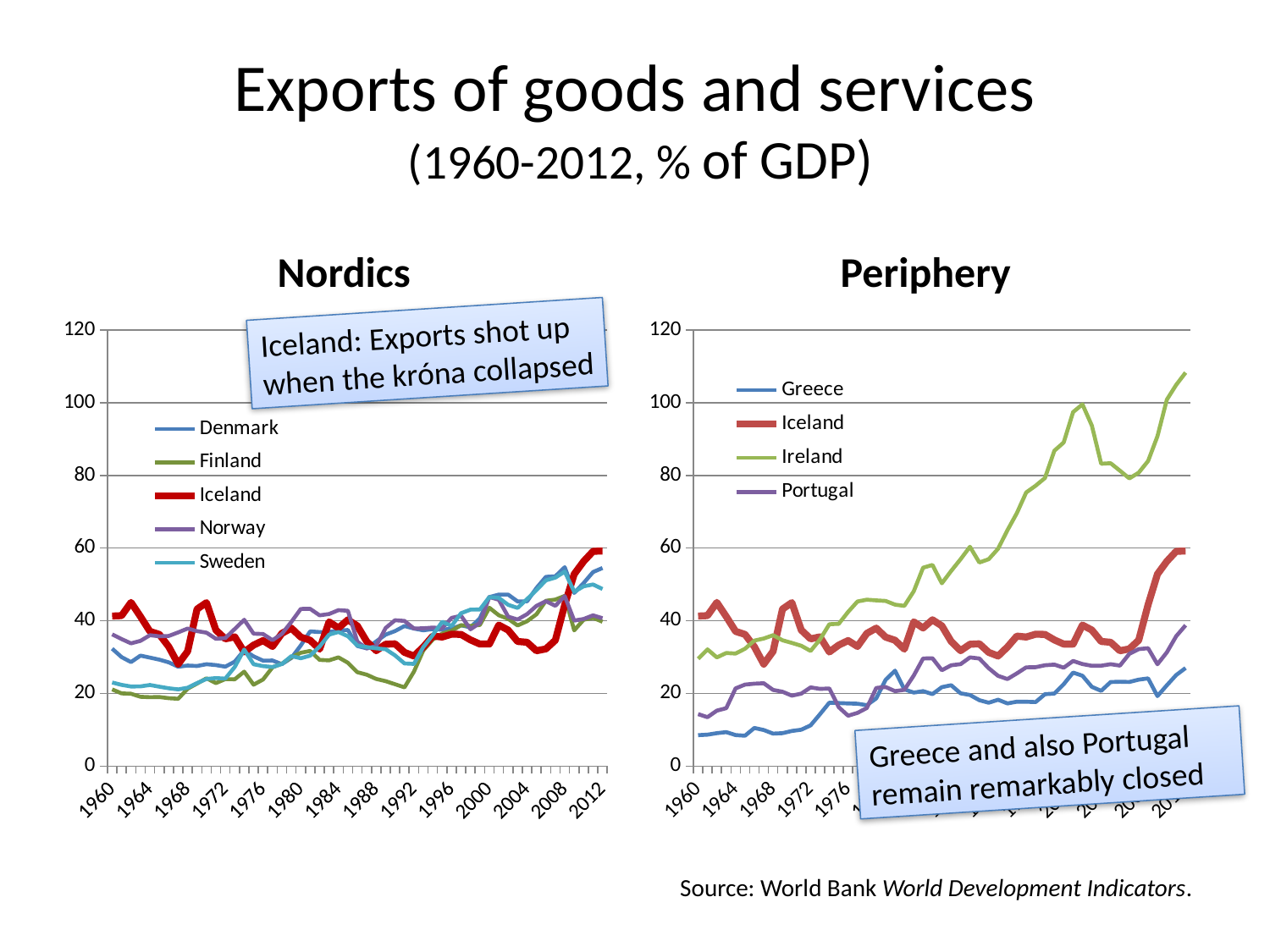
In the Periphery chart, is the value for Ireland in 2012 greater or less than 100? greater What is the highest value shown on the vertical axis of the Periphery chart? 120 In the Periphery chart, which series has the lowest value in 2012? Greece How many series does the legend of the Nordics chart list? 5 In the Periphery chart, which series has the highest value in 2012? Ireland In the Periphery chart, does the Ireland series overall rise or fall from 1960 to 2012? rise Which series appears in the legends of both the Nordics chart and the Periphery chart? Iceland What kind of chart is the Nordics chart? line chart In the Nordics chart, which series has the highest value in 2012? Iceland How many series does the legend of the Periphery chart list? 4 In the Nordics chart, is the value for Finland in 1960 greater or less than 40? less In the Periphery chart, is the value for Greece in 1960 greater or less than 20? less